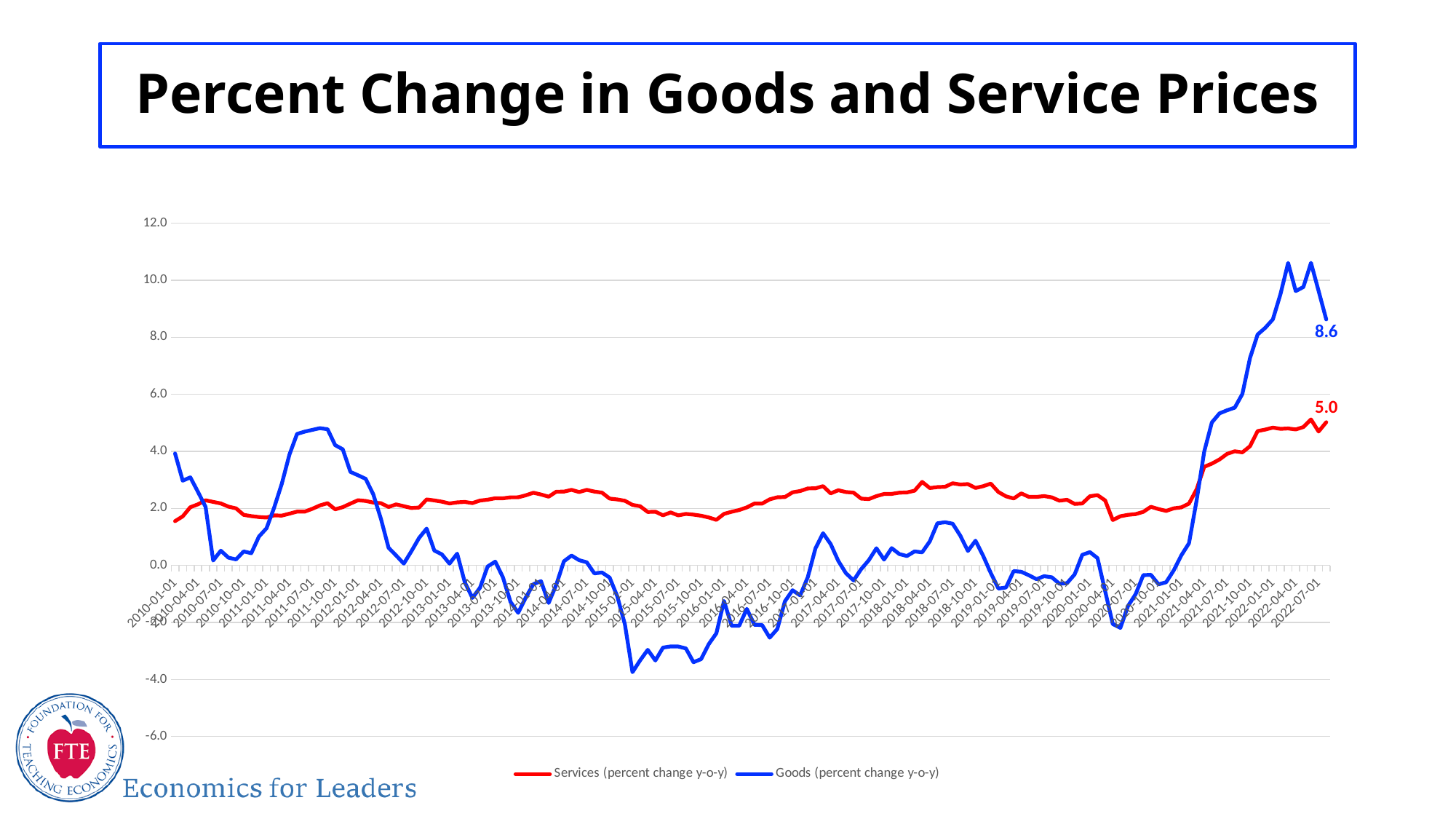
Which series reaches the highest value anywhere on the chart? Goods (percent change y-o-y) At the end of the chart, which series has the larger labelled value, Goods or Services? Goods How many series does the legend list? 2 Is the lowest value reached by the Goods line greater or less than -2.0? less What is the title of the chart? Percent Change in Goods and Service Prices What kind of chart is shown on the slide? line chart What colour is the Goods (percent change y-o-y) line? blue What is the labelled final value of the Services (percent change y-o-y) line? 5.0 What is the difference between the labelled final values of the Goods line (8.6) and the Services line (5.0)? 3.6 Is the highest value reached by the Goods line greater or less than 10.0? greater What is the labelled final value of the Goods (percent change y-o-y) line? 8.6 Does the Goods line rise or fall between 2021-01-01 and 2022-04-01? rise